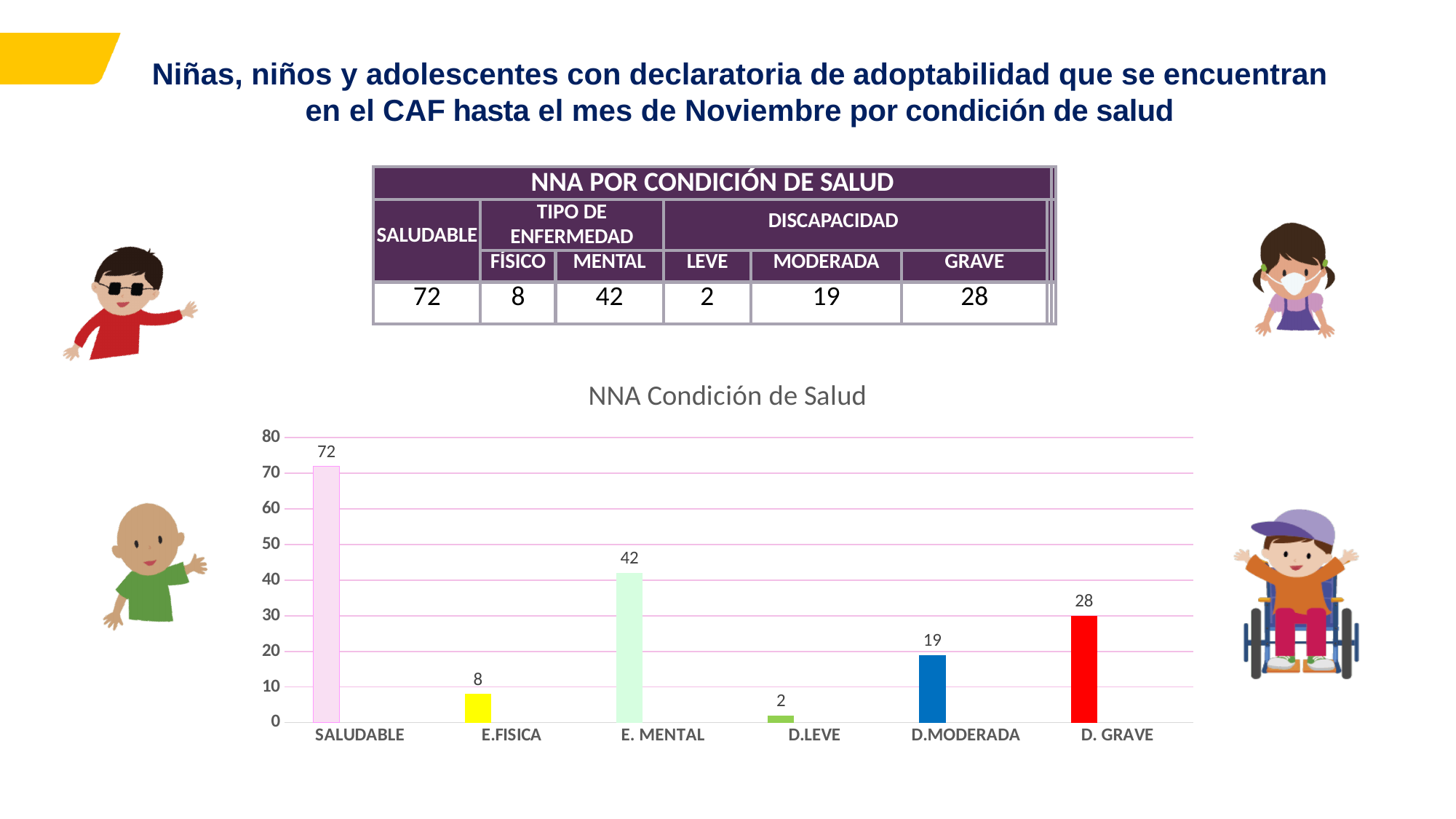
Which category has the highest value in the chart? SALUDABLE How many categories are shown on the x axis of the chart? 6 What is the difference between the values for D. GRAVE and D.MODERADA? 9 What is the value for SALUDABLE in the chart? 72 What is the title of the chart? NNA Condición de Salud Which category has the lowest value in the chart? D.LEVE What kind of chart is shown on the slide? Bar chart What is the difference between the values for SALUDABLE and E. MENTAL? 30 What is the value for D.MODERADA in the chart? 19 What is the value for E. MENTAL in the chart? 42 What colour is the bar for D. GRAVE? Red Which is larger, the value for E.FISICA or the value for D. GRAVE? D. GRAVE